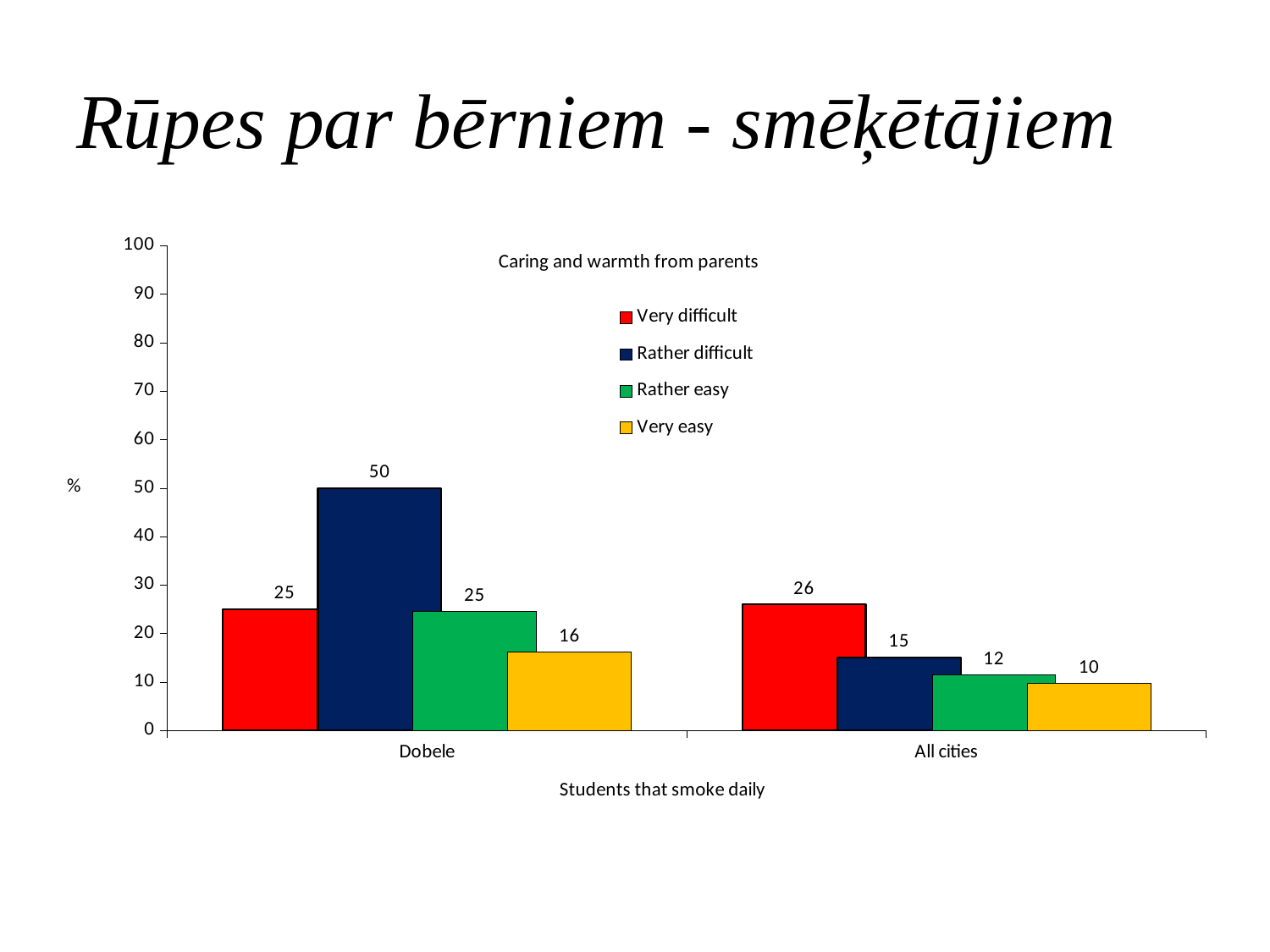
Which series has the highest value in Dobele? Rather difficult Is the value for Rather difficult in Dobele greater or less than 40? greater What is the difference between Rather difficult in Dobele and Rather difficult in All cities? 35 What kind of chart is shown? bar chart Which is larger: Rather easy in Dobele or Rather easy in All cities? Rather easy in Dobele Which series has the lowest value in All cities? Very easy What is the title of the chart? Caring and warmth from parents What is the value for Very difficult in All cities? 26 What is the value for Rather difficult in Dobele? 50 What is the value for Very easy in All cities? 10 How many series does the legend list? 4 How many categories are shown on the x axis? 2